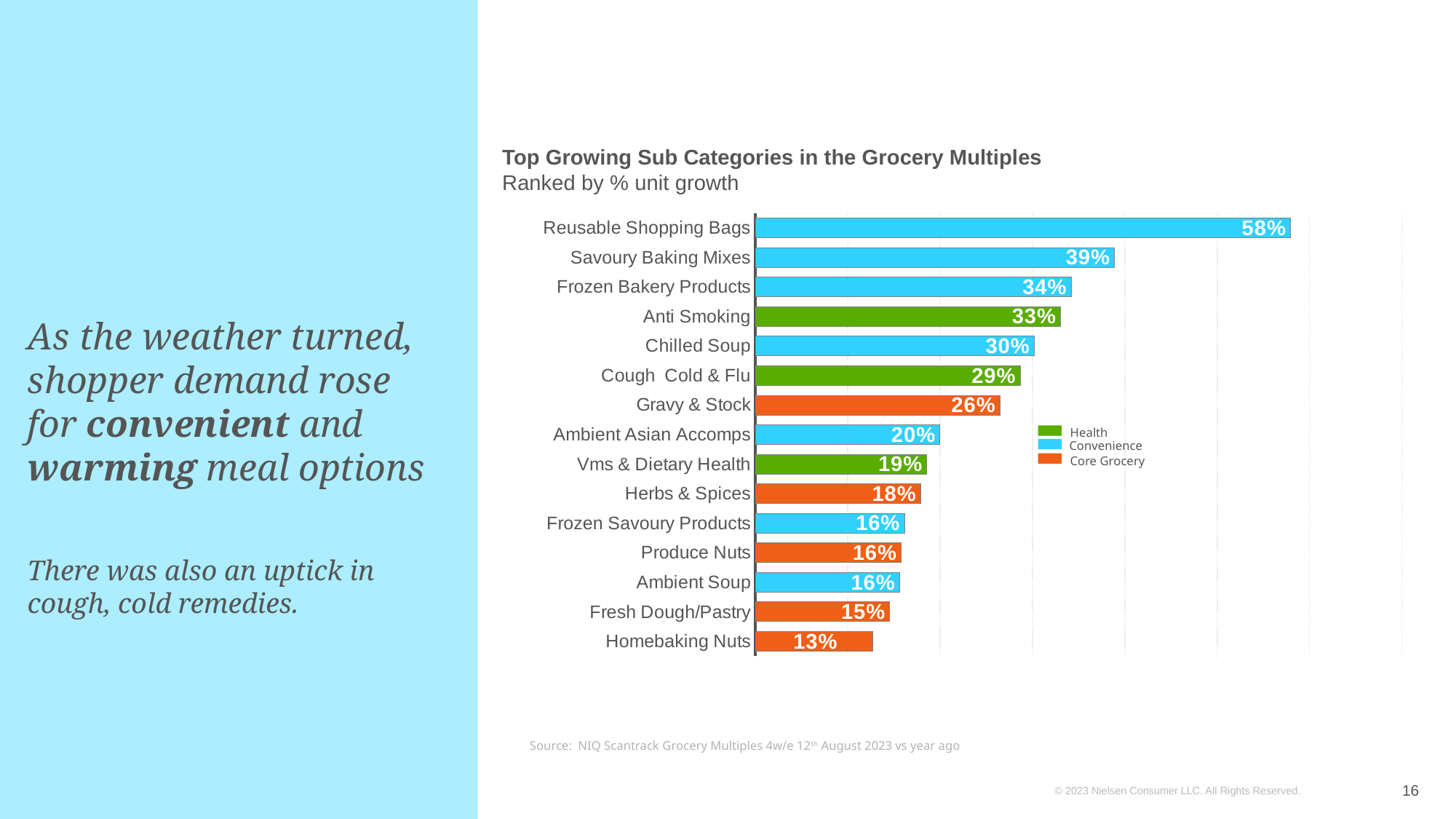
How many sub categories are shown in the chart? 15 What is the difference in % unit growth between Gravy & Stock and Herbs & Spices? 8% What kind of chart is shown on the slide? Bar chart Which sub category has the highest % unit growth? Reusable Shopping Bags Which legend category does the Gravy & Stock bar belong to? Core Grocery Which has higher % unit growth, Anti Smoking or Chilled Soup? Anti Smoking What is the difference in % unit growth between Savoury Baking Mixes and Frozen Bakery Products? 5% What is the % unit growth for Cough Cold & Flu? 29% How many series does the legend list? 3 Which sub category has the lowest % unit growth? Homebaking Nuts What is the % unit growth for Reusable Shopping Bags? 58% What is the % unit growth for Homebaking Nuts? 13%